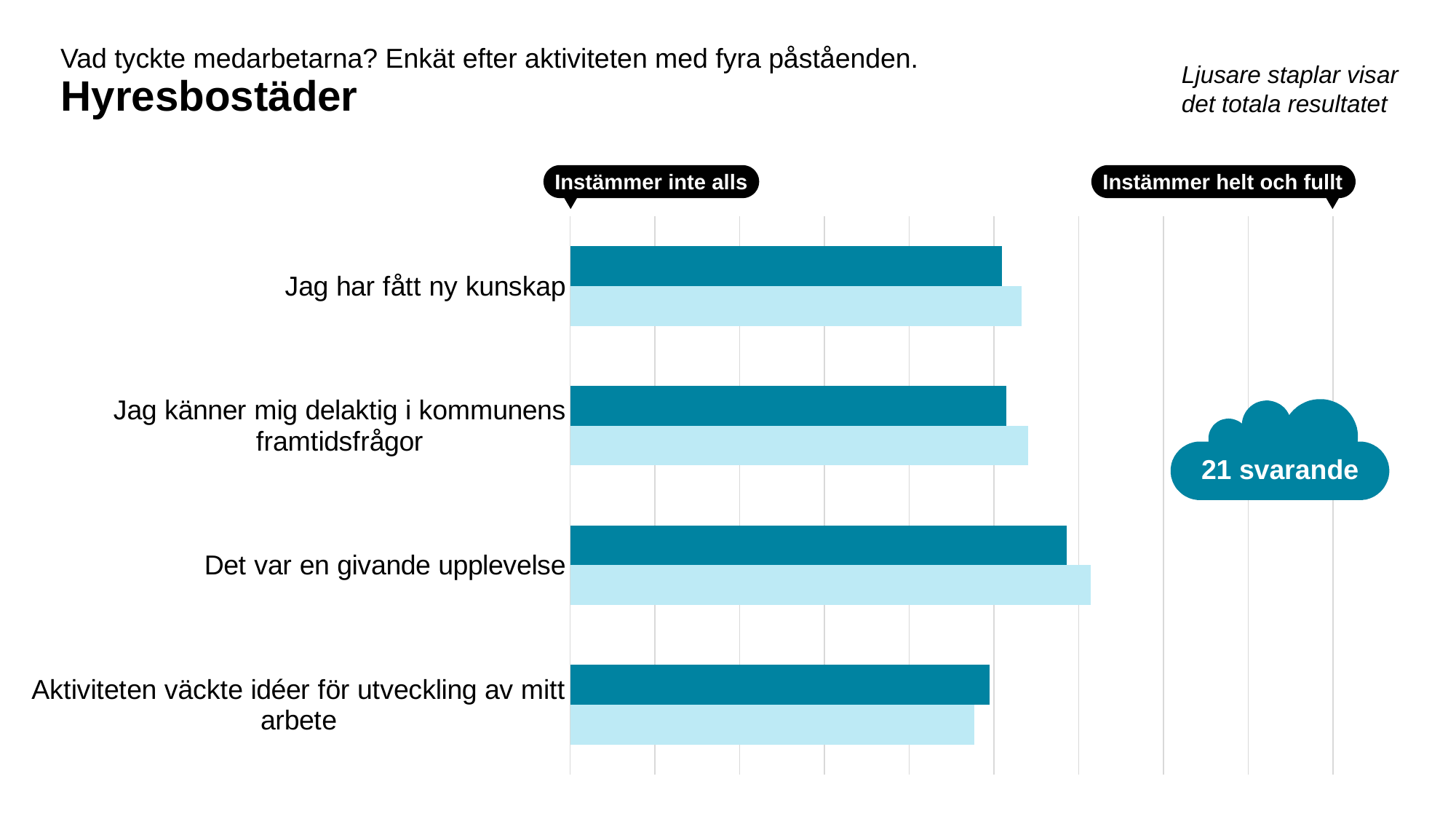
According to the note on the slide, what do the lighter bars show? Det totala resultatet What kind of chart is shown on the slide? Bar chart For 'Det var en givande upplevelse', which bar is longer, the dark blue or the light blue one? Light blue Which statement has the longest dark blue bar? Det var en givande upplevelse How many respondents does the slide report? 21 svarande For 'Jag har fått ny kunskap', which bar is longer, the dark blue or the light blue one? Light blue How many statements (categories) are shown in the chart? 4 Which statement has the longest light blue bar? Det var en givande upplevelse Which statement has the shortest light blue bar? Aktiviteten väckte idéer för utveckling av mitt arbete Which dark blue bar is longer: 'Det var en givande upplevelse' or 'Jag har fått ny kunskap'? Det var en givande upplevelse How many bar series are plotted for each statement? 2